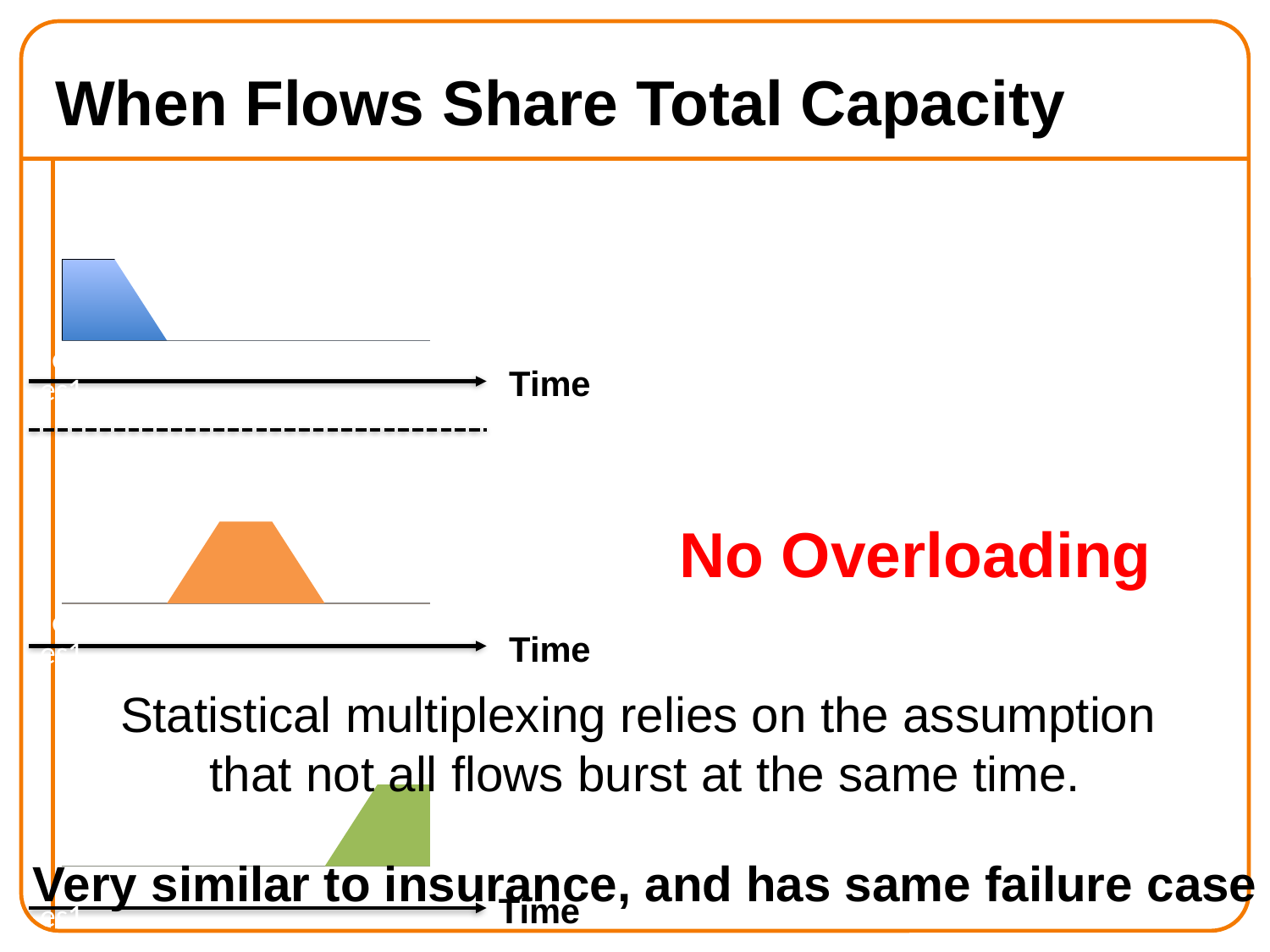
In the bottom chart, does the green flow's value rise or fall along the time axis? rise What colour is the filled area in the middle chart? orange How many charts are shown on the slide? 3 In the top chart, does the blue flow's value rise or fall along the time axis? fall What is the x-axis label of the top chart? Time What kind of chart is the top chart on the slide? area chart